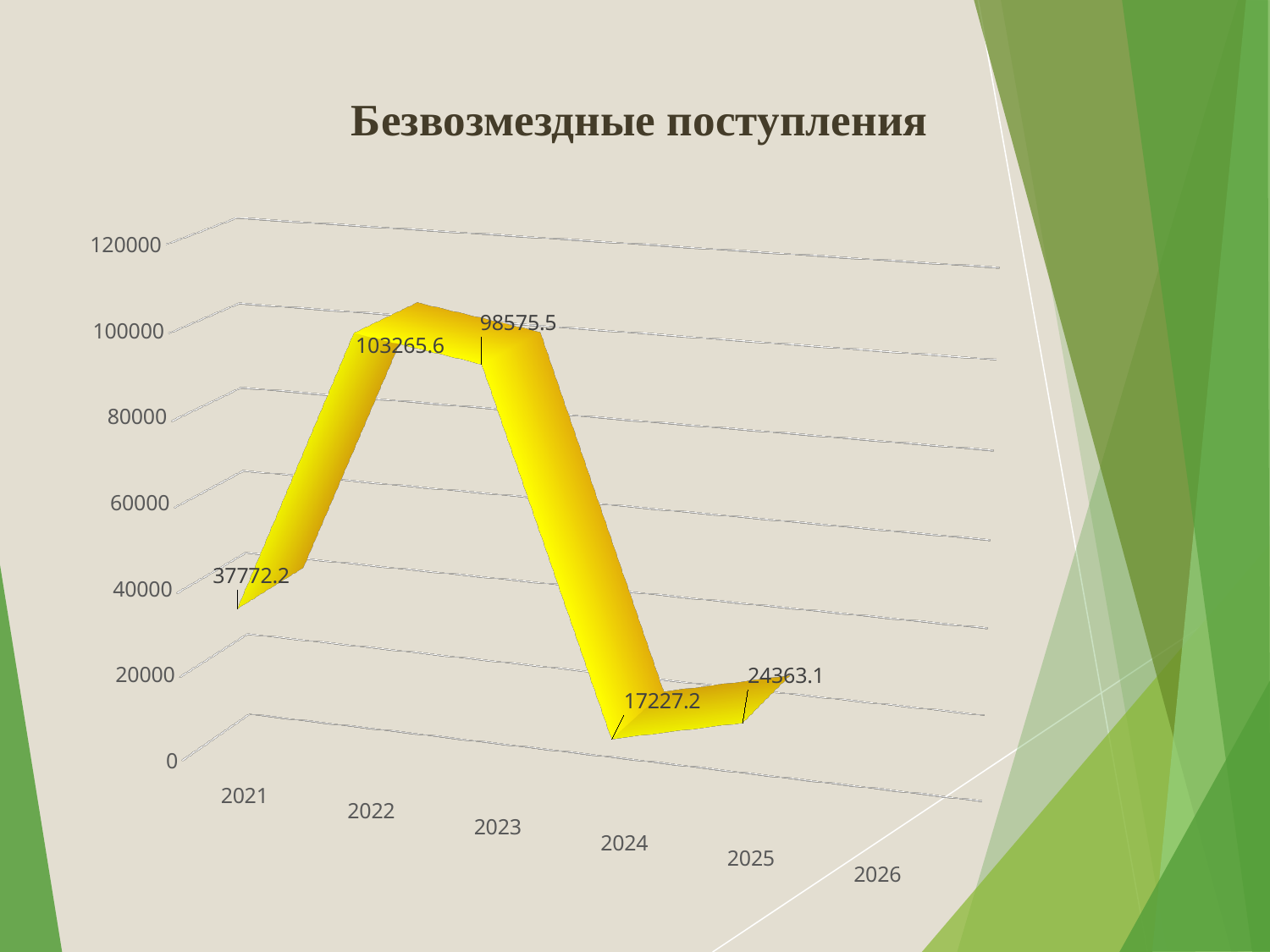
Which is larger, the value for 2021 or the value for 2025? 2021 Which year has the lowest value? 2024 Does the value fall or rise from 2023 to 2024? fall What is the value for 2024? 17227.2 What is the value for 2025? 24363.1 What is the value for 2022? 103265.6 What is the value for 2021? 37772.2 What is the difference between the values for 2022 and 2023? 4690.1 What is the difference between the values for 2025 and 2024? 7135.9 What is the title of the chart? Безвозмездные поступления What kind of chart is shown on the slide? line chart Which year has the highest value? 2022